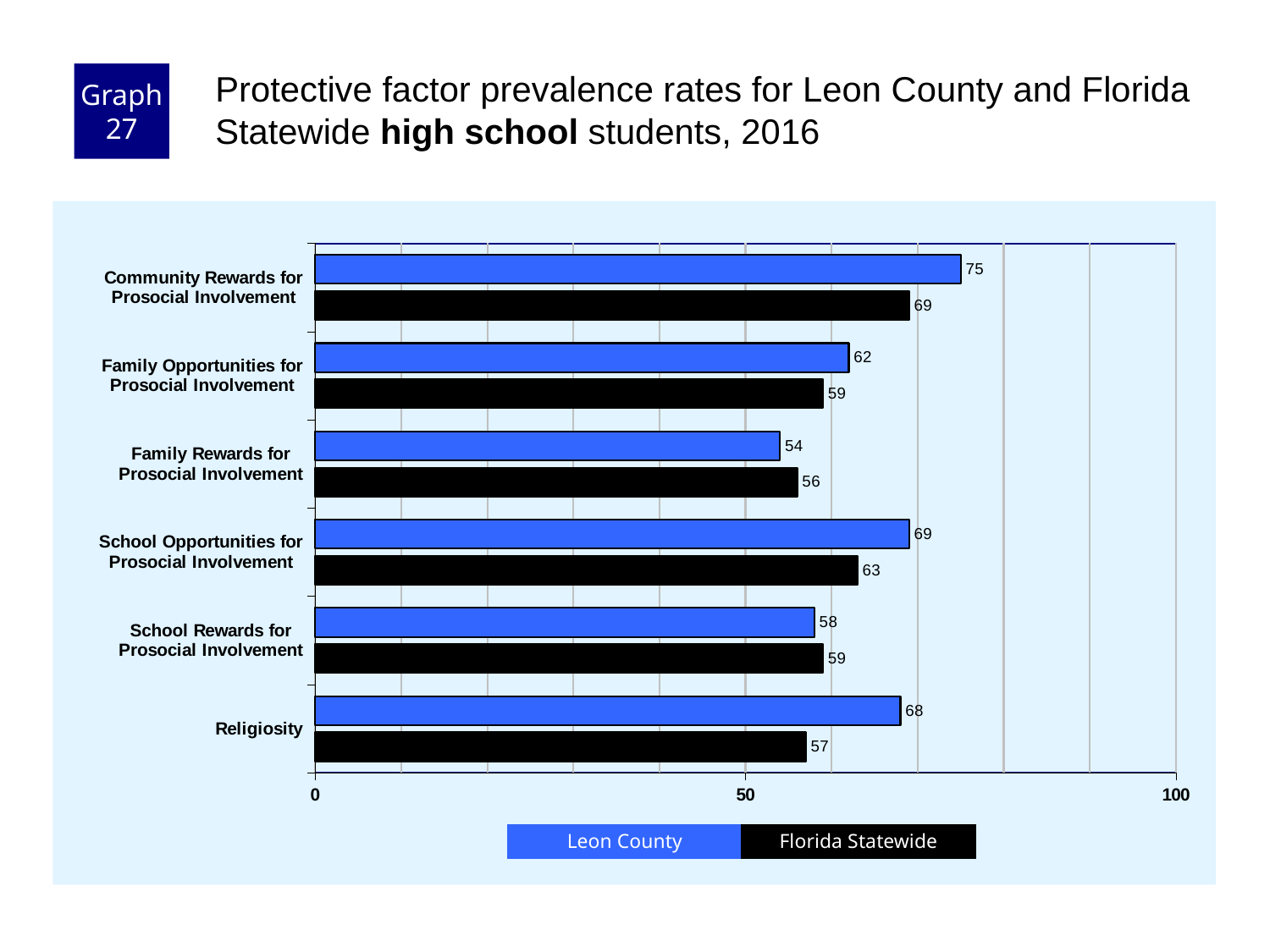
For Family Rewards for Prosocial Involvement, which is larger: the Leon County value or the Florida Statewide value? Florida Statewide What is the Leon County value for Community Rewards for Prosocial Involvement? 75 Which protective factor has the highest Leon County value? Community Rewards for Prosocial Involvement Which protective factor has the lowest Leon County value? Family Rewards for Prosocial Involvement Is the Leon County value for Community Rewards for Prosocial Involvement greater or less than 50? greater What is the Florida Statewide value for School Opportunities for Prosocial Involvement? 63 How many protective factors are shown on the chart? 6 How many series does the legend list? 2 What is the Florida Statewide value for Religiosity? 57 What is the difference between the Leon County and Florida Statewide values for Religiosity? 11 What kind of chart is shown on the slide? bar chart What is the difference between the Leon County and Florida Statewide values for Community Rewards for Prosocial Involvement? 6